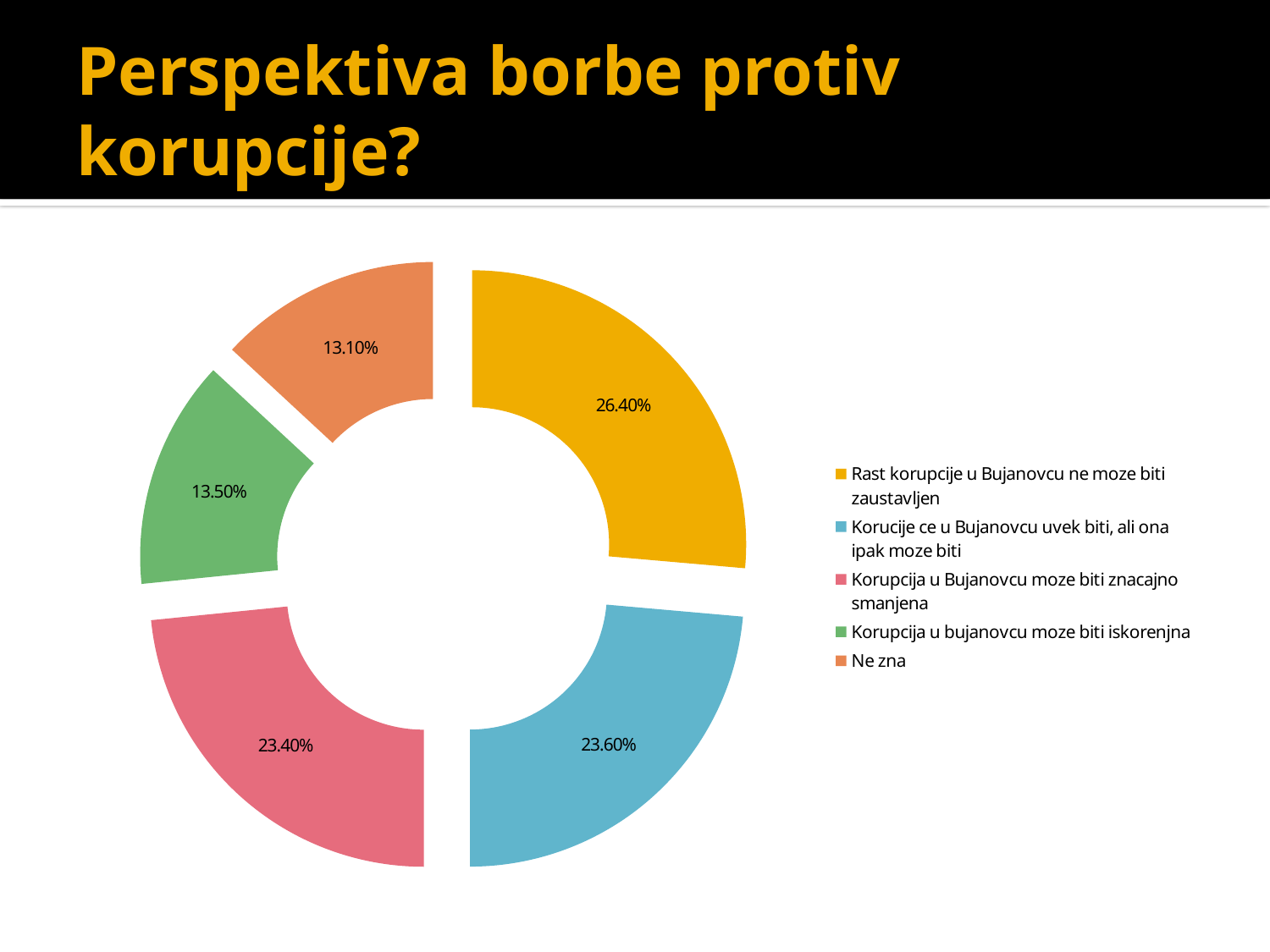
What percentage is shown for "Korupcija u Bujanovcu moze biti znacajno smanjena"? 23.40% What colour is the slice for "Ne zna"? orange Which is larger: the share for "Korucije ce u Bujanovcu uvek biti, ali ona ipak moze biti" or the share for "Korupcija u Bujanovcu moze biti znacajno smanjena"? Korucije ce u Bujanovcu uvek biti, ali ona ipak moze biti What percentage is shown for "Rast korupcije u Bujanovcu ne moze biti zaustavljen"? 26.40% How many slices does the chart have? 5 Which category has the largest share of the chart? Rast korupcije u Bujanovcu ne moze biti zaustavljen Which category has the smallest share of the chart? Ne zna What kind of chart is shown on the slide? doughnut chart What percentage is shown for "Korupcija u bujanovcu moze biti iskorenjna"? 13.50% What is the difference in percentage points between "Rast korupcije u Bujanovcu ne moze biti zaustavljen" and "Korucije ce u Bujanovcu uvek biti, ali ona ipak moze biti"? 2.80 percentage points What share of the chart does the blue slice represent? 23.60% What percentage is shown for "Ne zna"? 13.10%